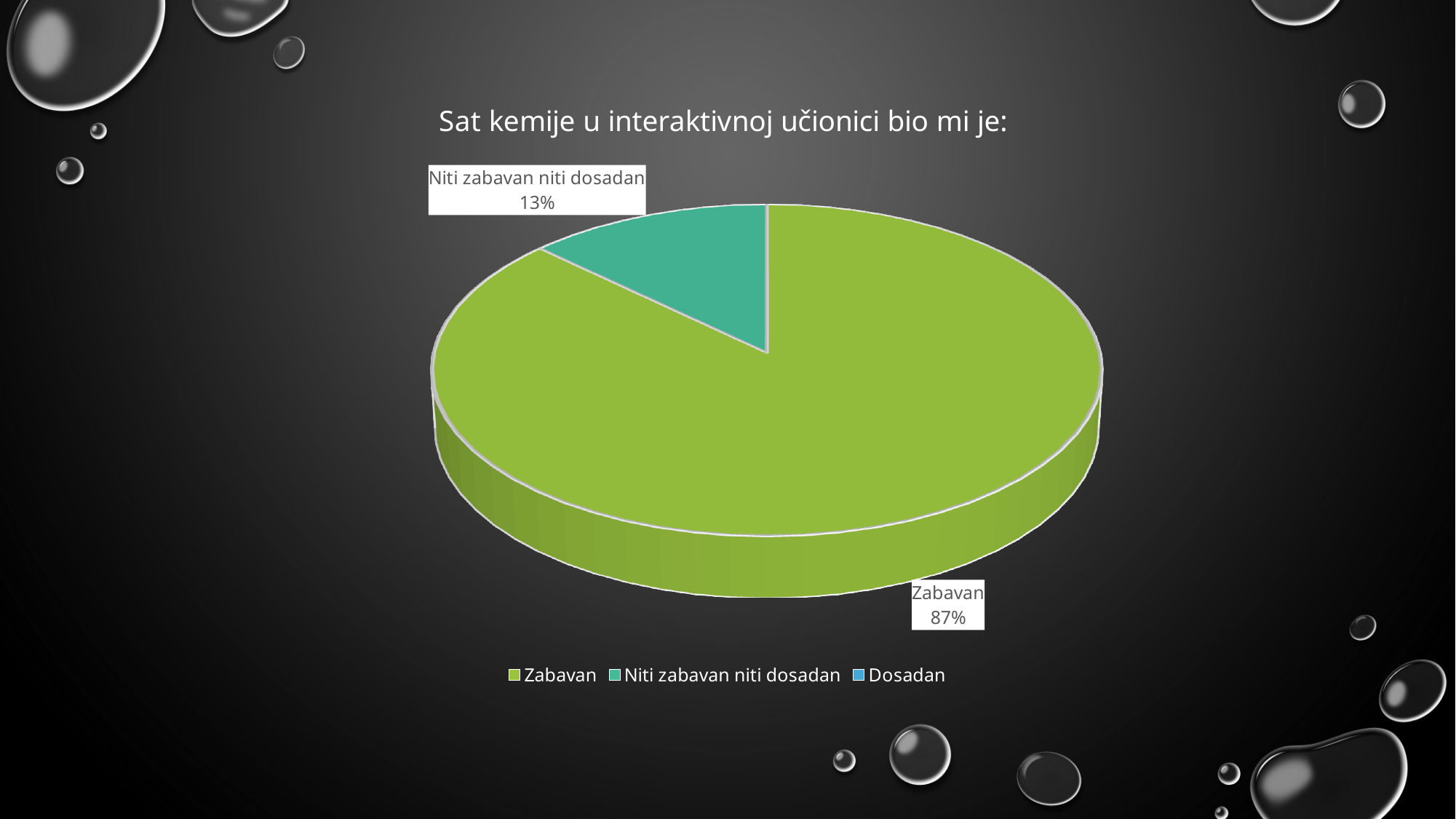
Which category has the largest slice of the pie? Zabavan What share of the pie does the "Niti zabavan niti dosadan" slice represent? 13% How many slices have a visible data label on the pie? 2 Is the share for "Zabavan" greater or less than 50%? greater Which of the two labelled slices is larger, "Zabavan" or "Niti zabavan niti dosadan"? Zabavan What is the title of the chart? Sat kemije u interaktivnoj učionici bio mi je: How many entries does the legend list? 3 Which legend entry does not have a visible slice in the pie? Dosadan What kind of chart is shown on the slide? pie chart What is the difference in percentage points between the "Zabavan" and "Niti zabavan niti dosadan" slices? 74 What share of the pie does the "Zabavan" slice represent? 87%